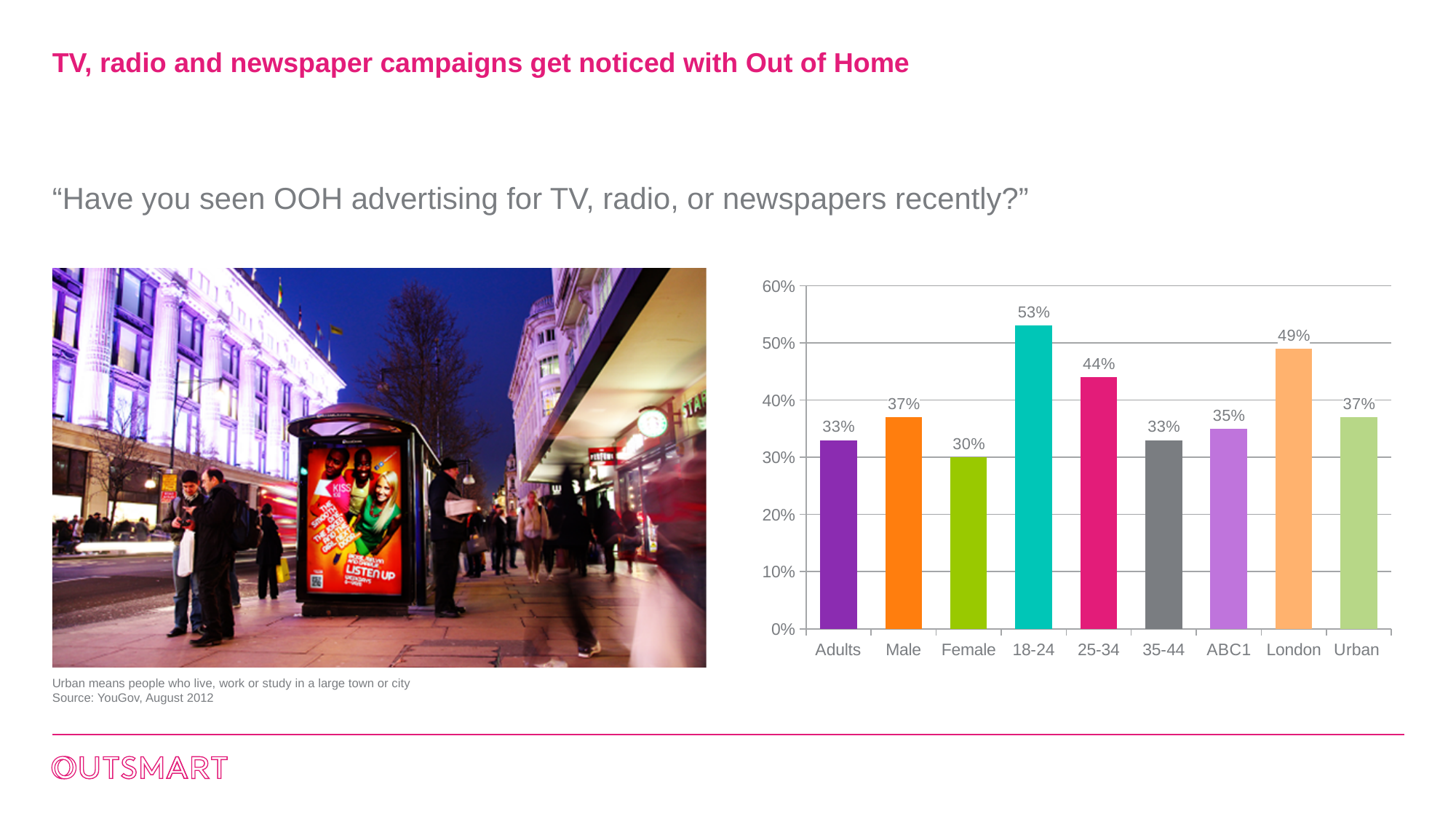
Is the value for 25-34 greater or less than 40%? greater What is the value for ABC1? 35% What is the difference between the values for 18-24 and 25-34? 9% What is the value for London? 49% Which category has the highest value? 18-24 What is the value for Female? 30% How many categories are shown on the x axis? 9 Which is larger, the value for London or the value for Urban? London Which category has the lowest value? Female What is the difference between the values for Male and Female? 7% What is the value for 18-24? 53% What kind of chart is shown on the slide? bar chart